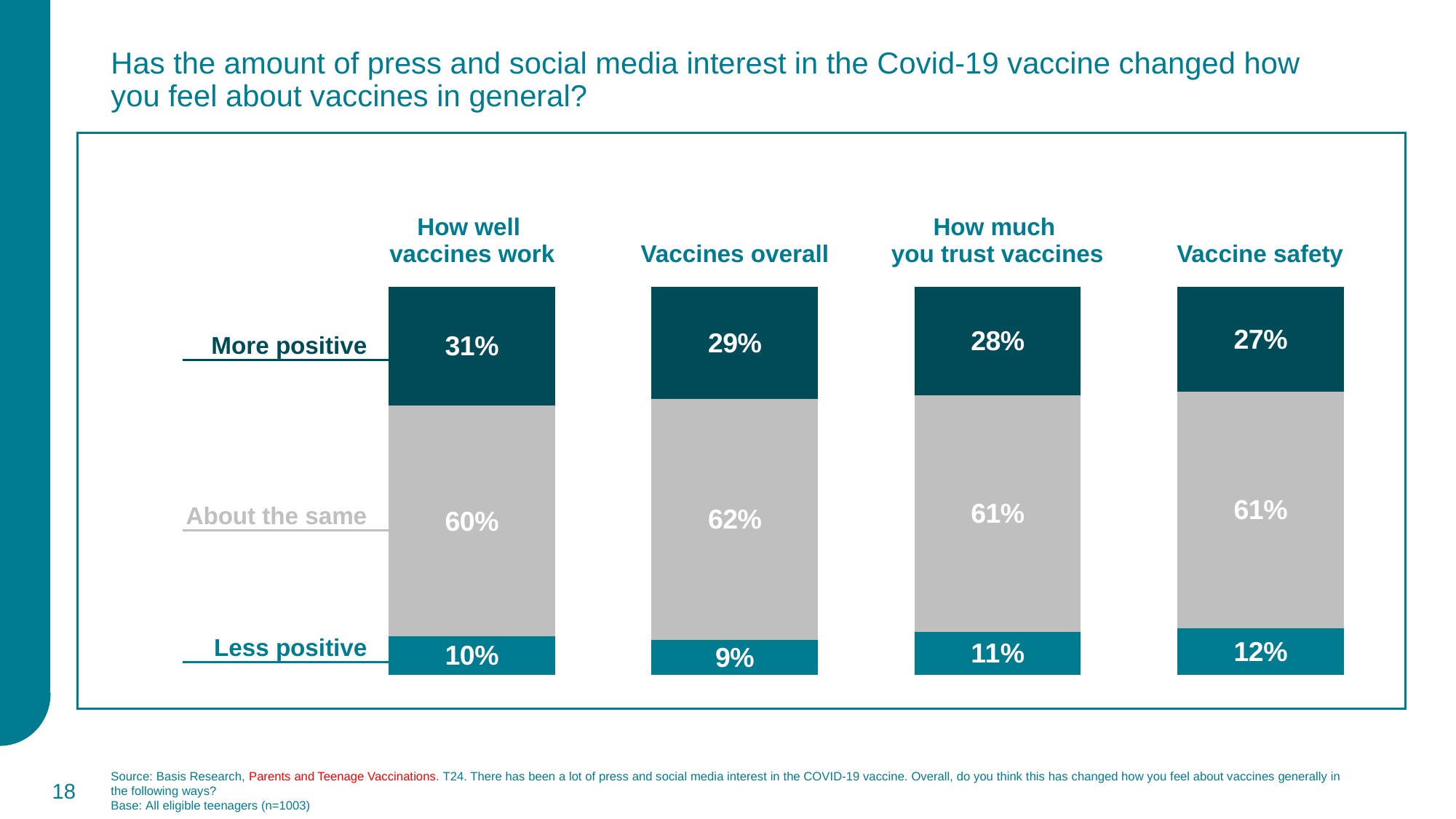
Which category has the highest 'More positive' percentage? How well vaccines work What kind of chart is shown on the slide? Stacked bar chart What percentage of respondents feel about the same about vaccines overall? 62% What percentage of respondents feel more positive about how much they trust vaccines? 28% How many categories are shown in the chart? 4 How many response options (series) are shown for each category? 3 Is the 'Less positive' percentage larger for vaccine safety or for vaccines overall? Vaccine safety What percentage of respondents feel less positive about vaccine safety? 12% Which category has the lowest 'Less positive' percentage? Vaccines overall What is the difference between the 'More positive' percentages for how well vaccines work and vaccine safety? 4 percentage points What is the total of the three segments for the 'Vaccines overall' bar? 100% What percentage of respondents feel more positive about how well vaccines work? 31%